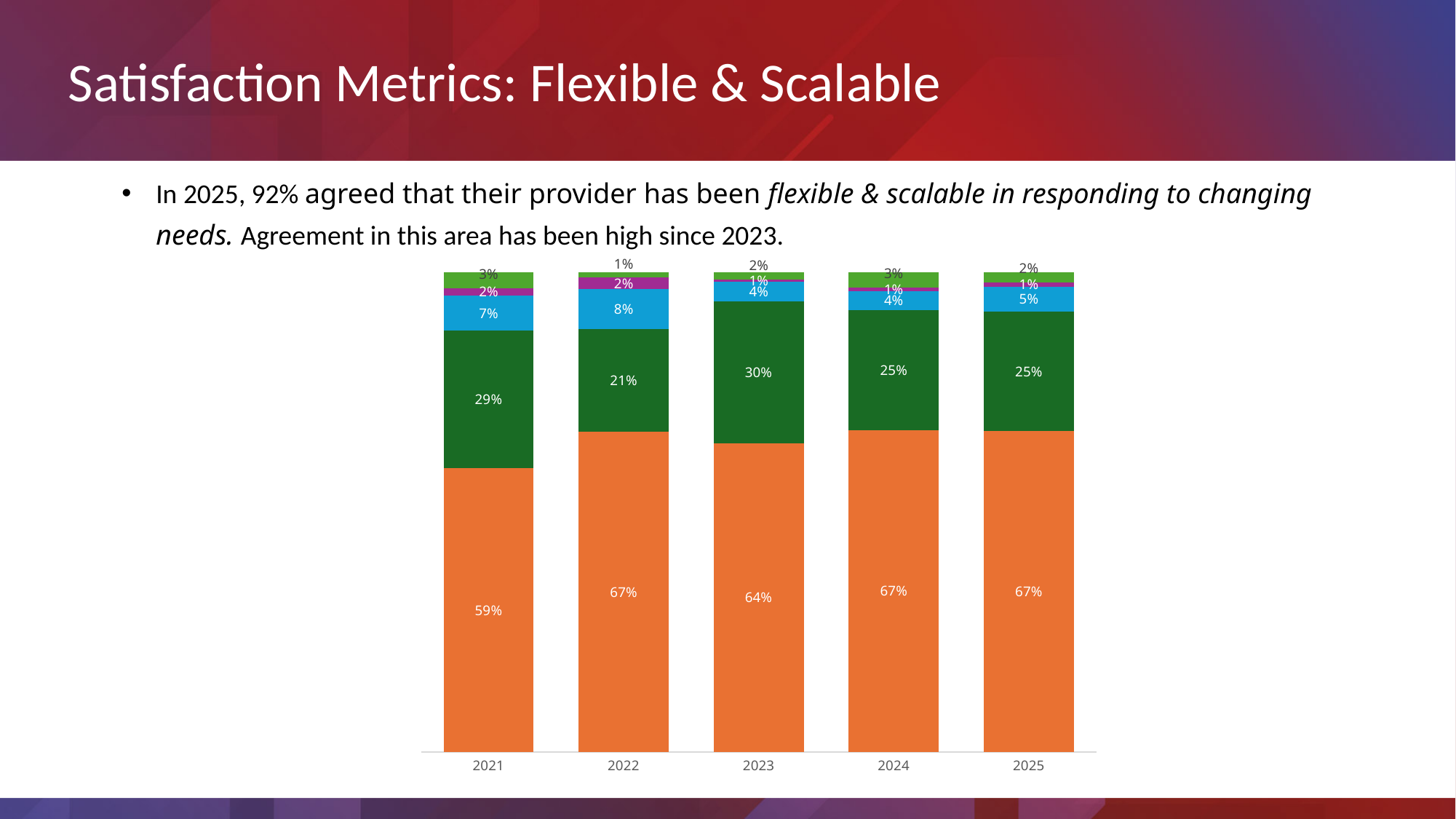
What is the difference between the bottom (orange) segment values for 2022 and 2021? 8 percentage points What is the value of the bottom (orange) segment of the bar for 2023? 64% Which year has the highest value for the blue segment? 2022 How many years are shown along the x axis of the chart? 5 What is the first year shown on the x axis of the chart? 2021 Which is larger, the dark green segment for 2021 or for 2024? 2021 What is the value of the dark green segment of the bar for 2022? 21% Which year has the highest value for the dark green segment? 2023 What is the value of the bottom (orange) segment of the bar for 2021? 59% What is the value of the blue segment of the bar for 2025? 5% Which year has the lowest value for the bottom (orange) segment? 2021 What kind of chart is shown on the slide? Stacked bar chart